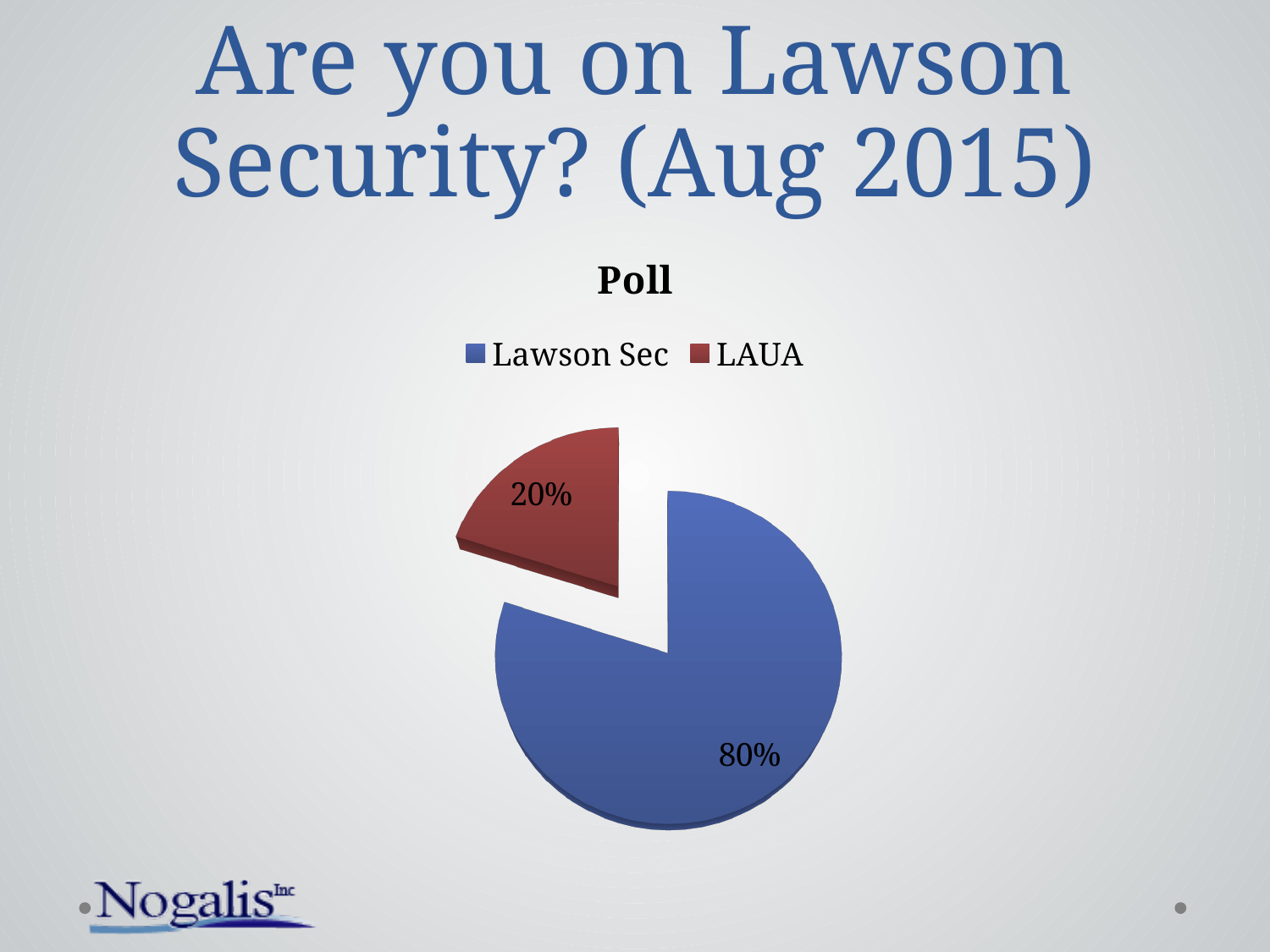
Which slice is the smallest? LAUA What share of the pie does Lawson Sec have? 80% How many slices does the pie chart have? 2 What colour is the LAUA slice? red Which is larger, Lawson Sec or LAUA? Lawson Sec What share of the pie does LAUA have? 20% How many entries does the legend list? 2 What is the chart's title? Poll Which slice is the largest? Lawson Sec What is the difference in percentage points between Lawson Sec and LAUA? 60 What kind of chart is shown on the slide? pie chart